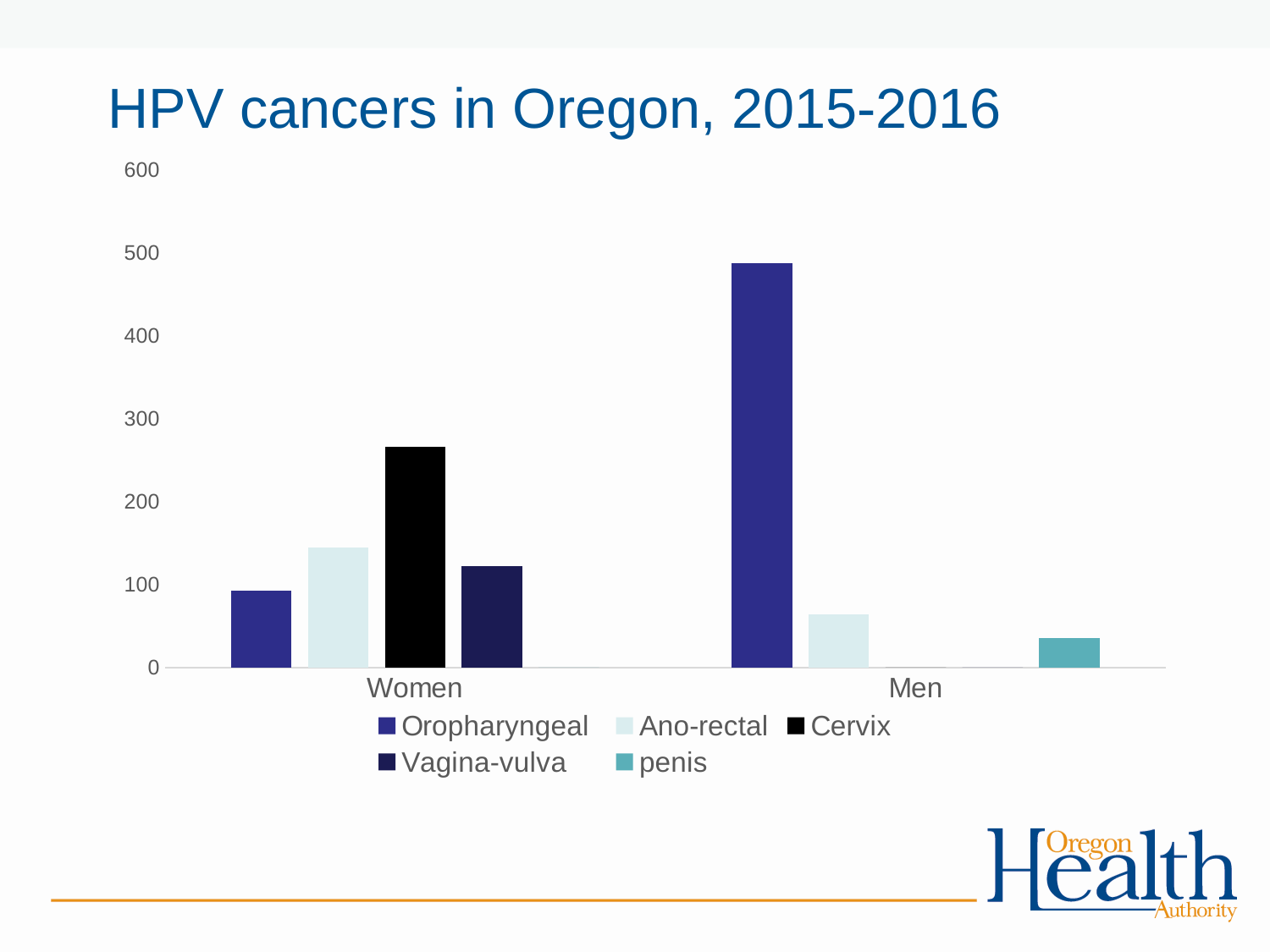
Which cancer type has the highest bar for Women? Cervix How many series does the legend list? 5 Is the Oropharyngeal value larger for Women or for Men? Men What is the title of the chart? HPV cancers in Oregon, 2015-2016 Is the Cervix value for Women greater or less than 200? greater Is the Oropharyngeal value for Men greater or less than 400? greater What type of chart is shown on the slide? bar chart Which cancer type has the highest bar for Men? Oropharyngeal How many categories are shown on the x axis? 2